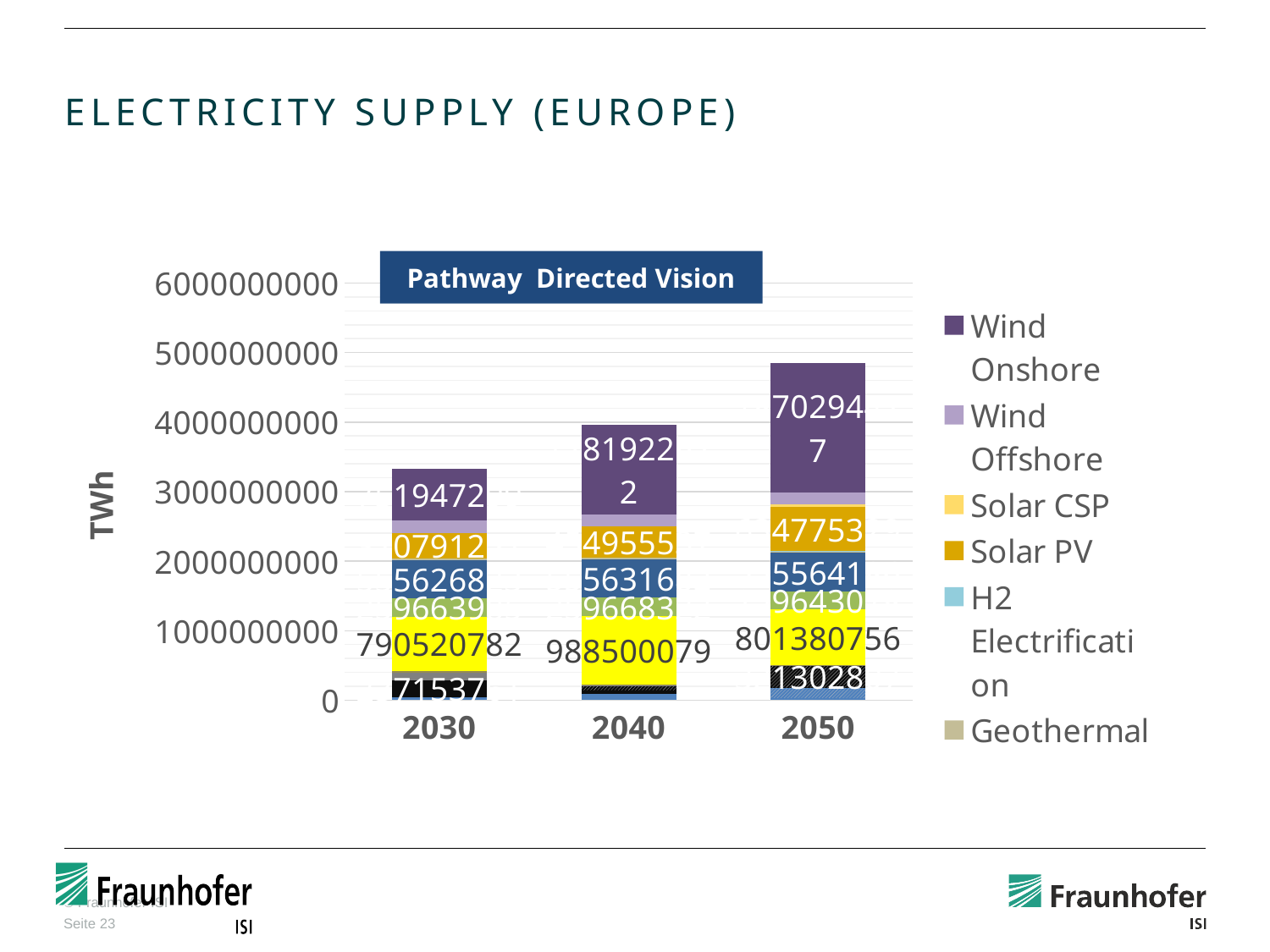
What pathway name is shown in the box at the top of the chart? Pathway Directed Vision Do the total bar heights rise or fall from 2030 to 2050? rise Which year has the highest total electricity supply in the chart? 2050 How many series does the legend of the chart list? 6 How many years (categories) are shown on the x axis of the chart? 3 Is the total bar for 2050 greater or less than 4000000000? greater Is the total bar for 2040 greater or less than 3000000000? greater What kind of chart is shown on the slide? Stacked bar chart Is the total bar for 2030 greater or less than 4000000000? less What is the label on the y axis of the chart? TWh Which is larger, the Wind Onshore segment in 2050 or the Wind Onshore segment in 2030? 2050 Which year has the lowest total electricity supply in the chart? 2030